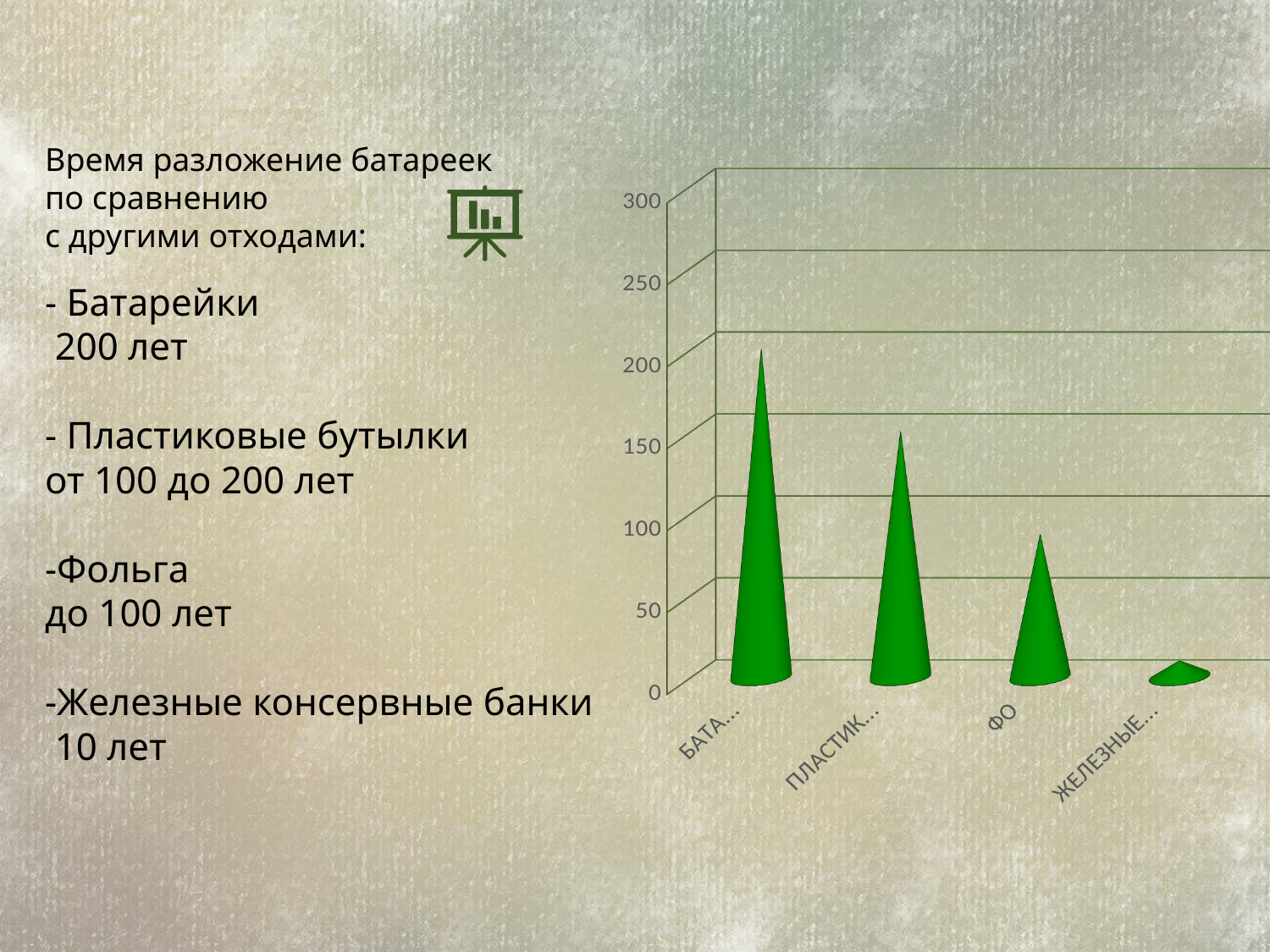
Which is larger on the chart, the value for БАТА... or the value for ПЛАСТИК...? БАТА... Which category has the highest value on the chart? БАТА... (batteries) Which category has the lowest value on the chart? ЖЕЛЕЗНЫЕ... (iron cans) Is the value for ФО greater or less than 150? less Do the values rise or fall from left to right along the x axis? fall What kind of chart is shown on the slide? bar chart Is the value for БАТА... greater or less than 150? greater How many categories are plotted on the chart? 4 Which is larger on the chart, the value for ФО or the value for ЖЕЛЕЗНЫЕ...? ФО What colour are the bars on the chart? green Is the value for ПЛАСТИК... greater or less than 200? less